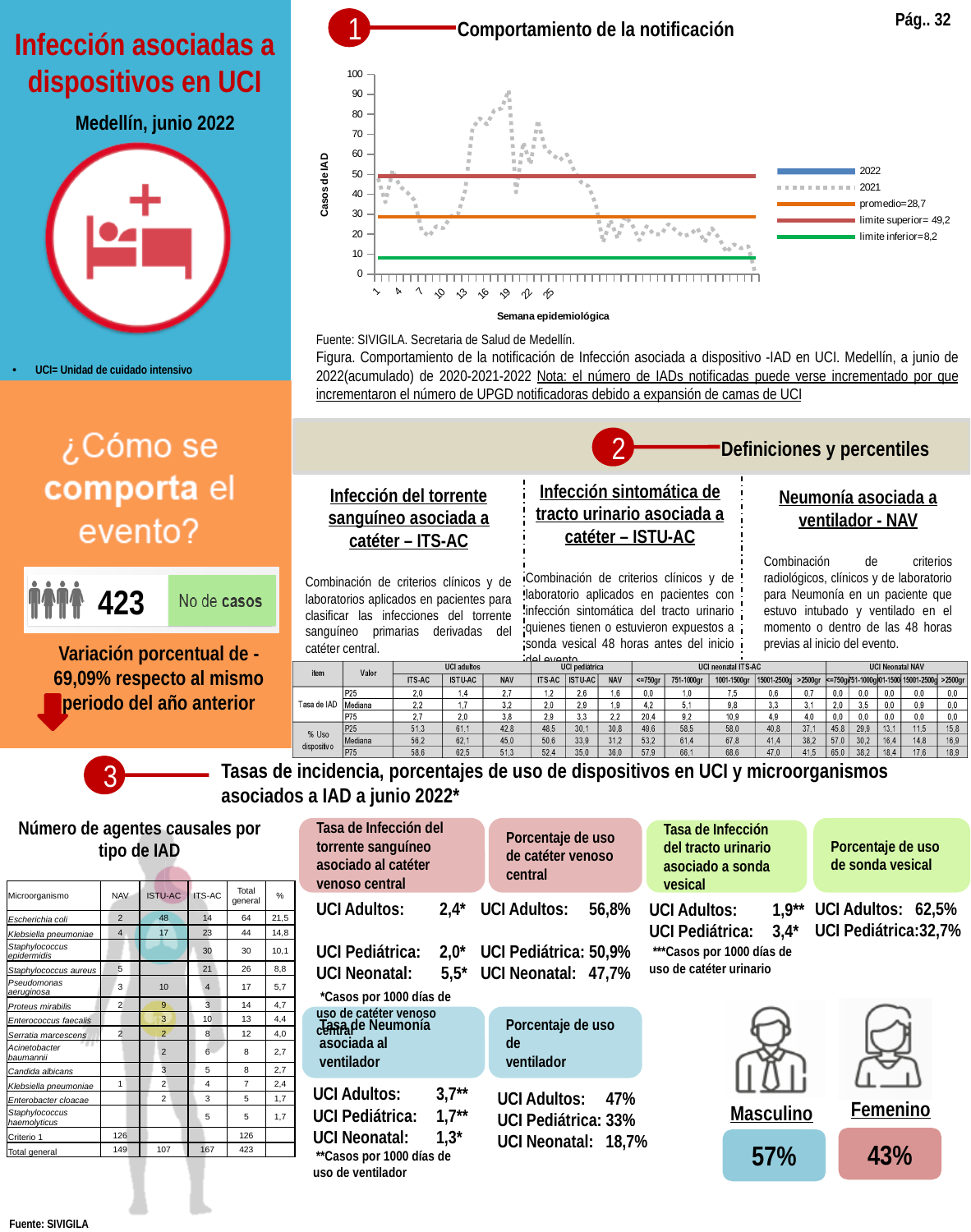
In the 'Comportamiento de la notificación' chart, does the 2021 series rise or fall from its peak near week 19 to the end of the x axis? fall In the 'Comportamiento de la notificación' chart, are the 2021 values in the last weeks shown greater or less than 30? less What is the y-axis title of the 'Comportamiento de la notificación' chart? Casos de IAD In the 'Comportamiento de la notificación' chart, what is the value of the 'limite superior' line? 49,2 In the 'Comportamiento de la notificación' chart, what is the difference between the 'limite superior' and the 'limite inferior' values? 41,0 How many series does the legend of the 'Comportamiento de la notificación' chart list? 5 In the 'Comportamiento de la notificación' chart, is the peak value of the 2021 series greater or less than 80? greater In the 'Comportamiento de la notificación' chart, which is larger, the 'limite superior' or the 'promedio'? limite superior What is the x-axis title of the 'Comportamiento de la notificación' chart? Semana epidemiológica What kind of chart is 'Comportamiento de la notificación'? line chart In the 'Comportamiento de la notificación' chart, what is the value of the 'promedio' line? 28,7 In the 'Comportamiento de la notificación' chart, what is the value of the 'limite inferior' line? 8,2